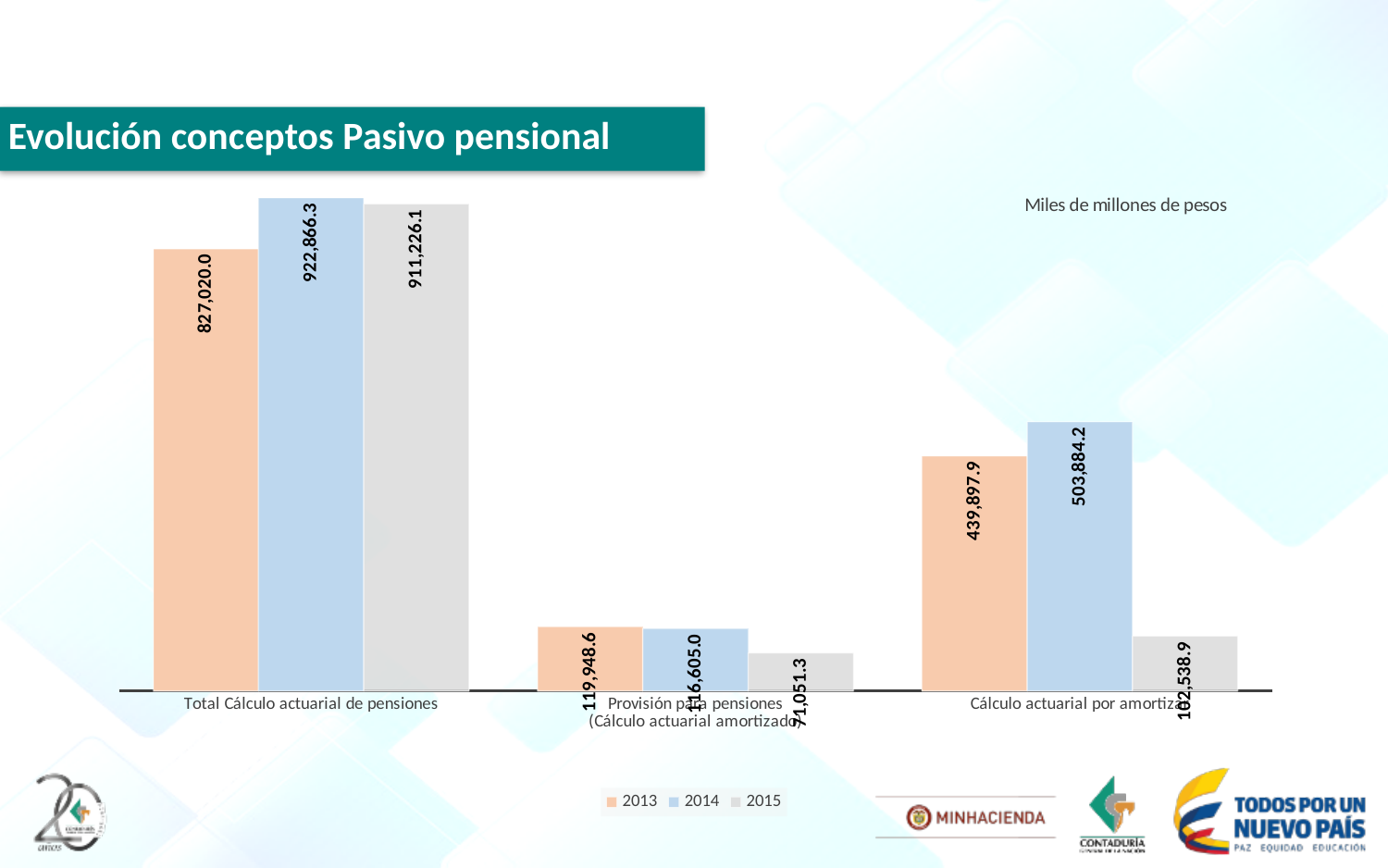
What is the value for 2013 in the Total Cálculo actuarial de pensiones category? 827,020.0 What is the difference between the 2014 and 2013 values in the Total Cálculo actuarial de pensiones category? 95,846.3 Which year has the highest value in the Total Cálculo actuarial de pensiones category? 2014 What kind of chart is shown on the slide? bar chart What unit of measurement is stated for the chart values? Miles de millones de pesos What is the difference between the 2014 and 2013 values in the Cálculo actuarial por amortizar category? 63,986.3 How many series does the legend list? 3 What is the value for 2013 in the Cálculo actuarial por amortizar category? 439,897.9 What is the value for 2014 in the Cálculo actuarial por amortizar category? 503,884.2 What is the value for 2014 in the Total Cálculo actuarial de pensiones category? 922,866.3 In the Cálculo actuarial por amortizar category, which year has the larger value, 2013 or 2014? 2014 What is the value for 2015 in the Total Cálculo actuarial de pensiones category? 911,226.1